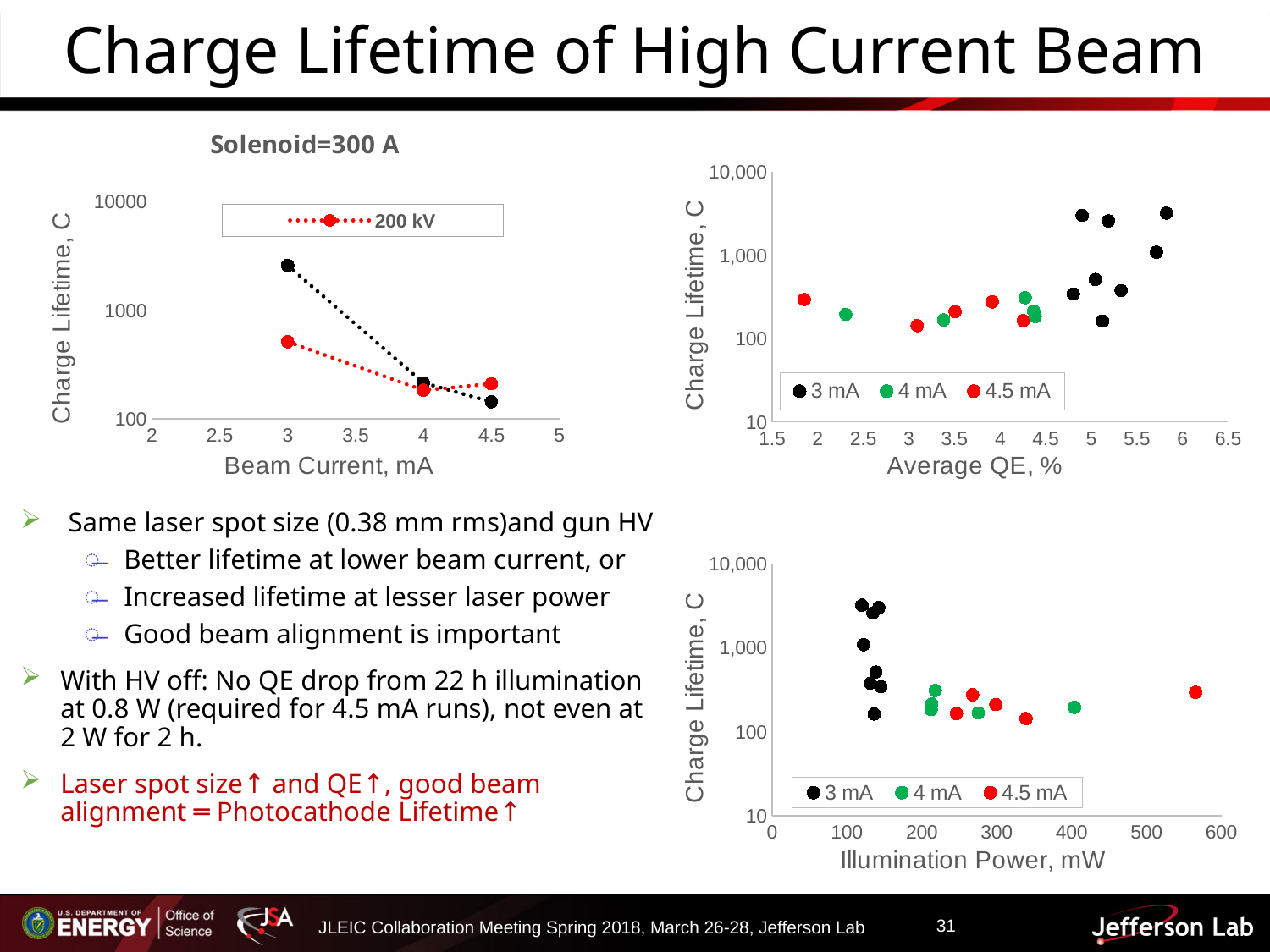
In the top-right chart (Charge Lifetime vs Average QE), is the 4.5 mA value near 3.1% QE greater or less than 1,000? less How many series does the legend of the bottom-right chart (Charge Lifetime vs Illumination Power) list? 3 In the left chart (Solenoid=300 A), is the 200 kV value at 3 mA greater or less than 1000? less In the top-right chart (Charge Lifetime vs Average QE), is the highest 3 mA value greater or less than 1,000? greater What is the x-axis label of the top-right chart? Average QE, % In the left chart (Solenoid=300 A), what is the only series named in the legend? 200 kV How many series does the legend of the top-right chart (Charge Lifetime vs Average QE) list? 3 In the bottom-right chart (Charge Lifetime vs Illumination Power), which series has the point at the highest illumination power? 4.5 mA What is the x-axis label of the bottom-right chart? Illumination Power, mW In the left chart (Solenoid=300 A), do the 200 kV values rise or fall as beam current increases from 3 mA to 4 mA? fall What kind of chart is the top-right chart (Charge Lifetime vs Average QE)? scatter chart